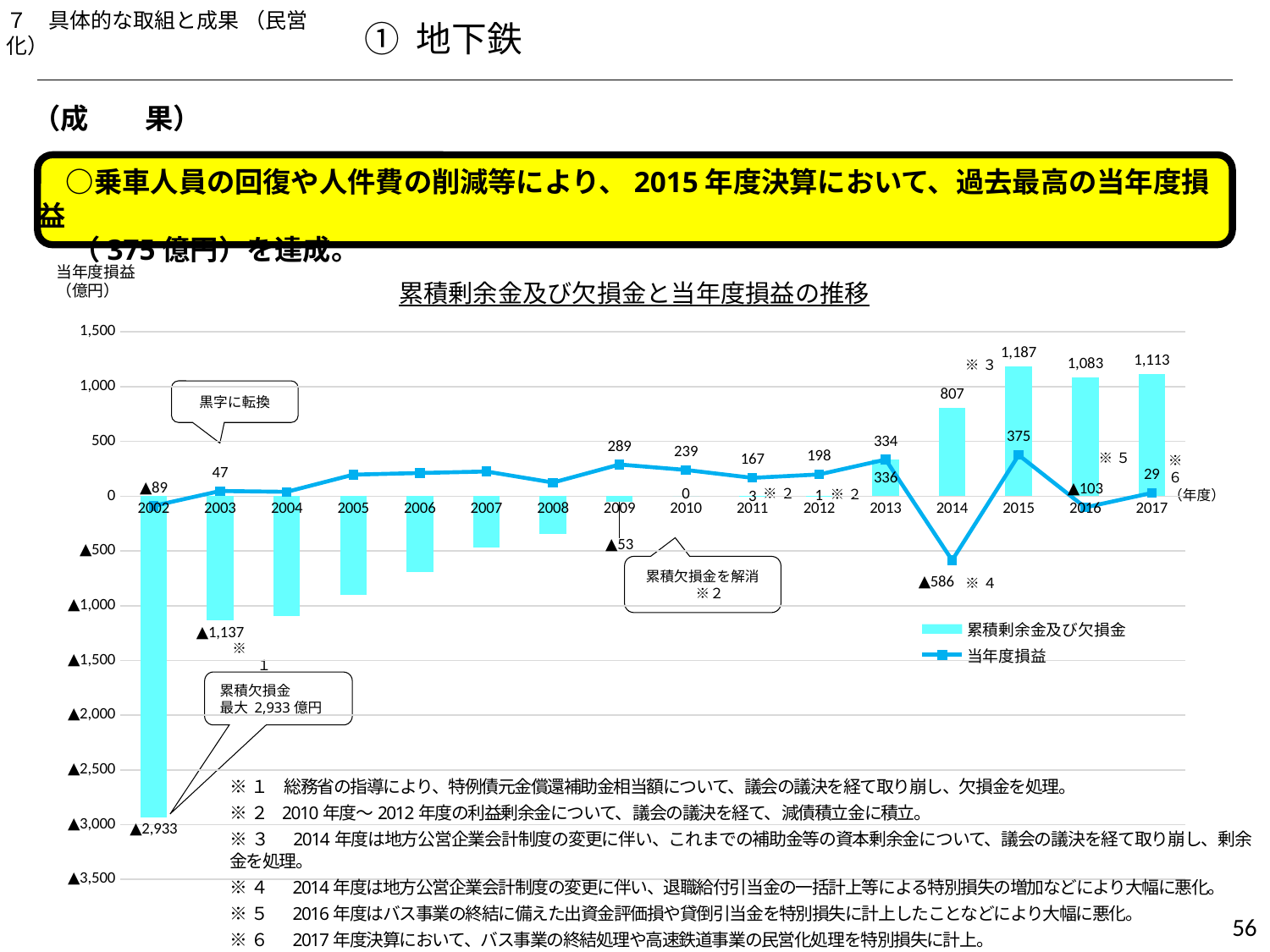
How many years are shown on the x axis? 16 In which year is the 累積剰余金及び欠損金 bar highest? 2015 What is the difference between the 当年度損益 values for 2015 and 2013? 41 Which year has the larger 累積剰余金及び欠損金 value, 2016 or 2017? 2017 What is the 累積剰余金及び欠損金 value for 2015? 1,187 What kind of chart is shown on the slide? A combined bar and line chart What is the 当年度損益 value for 2009? 289 How many series does the legend list? 2 In which year does the 当年度損益 line reach its highest value? 2015 In which year is the 累積剰余金及び欠損金 bar lowest? 2002 What is the 当年度損益 value for 2014? ▲586 What is the 累積剰余金及び欠損金 value for 2002? ▲2,933